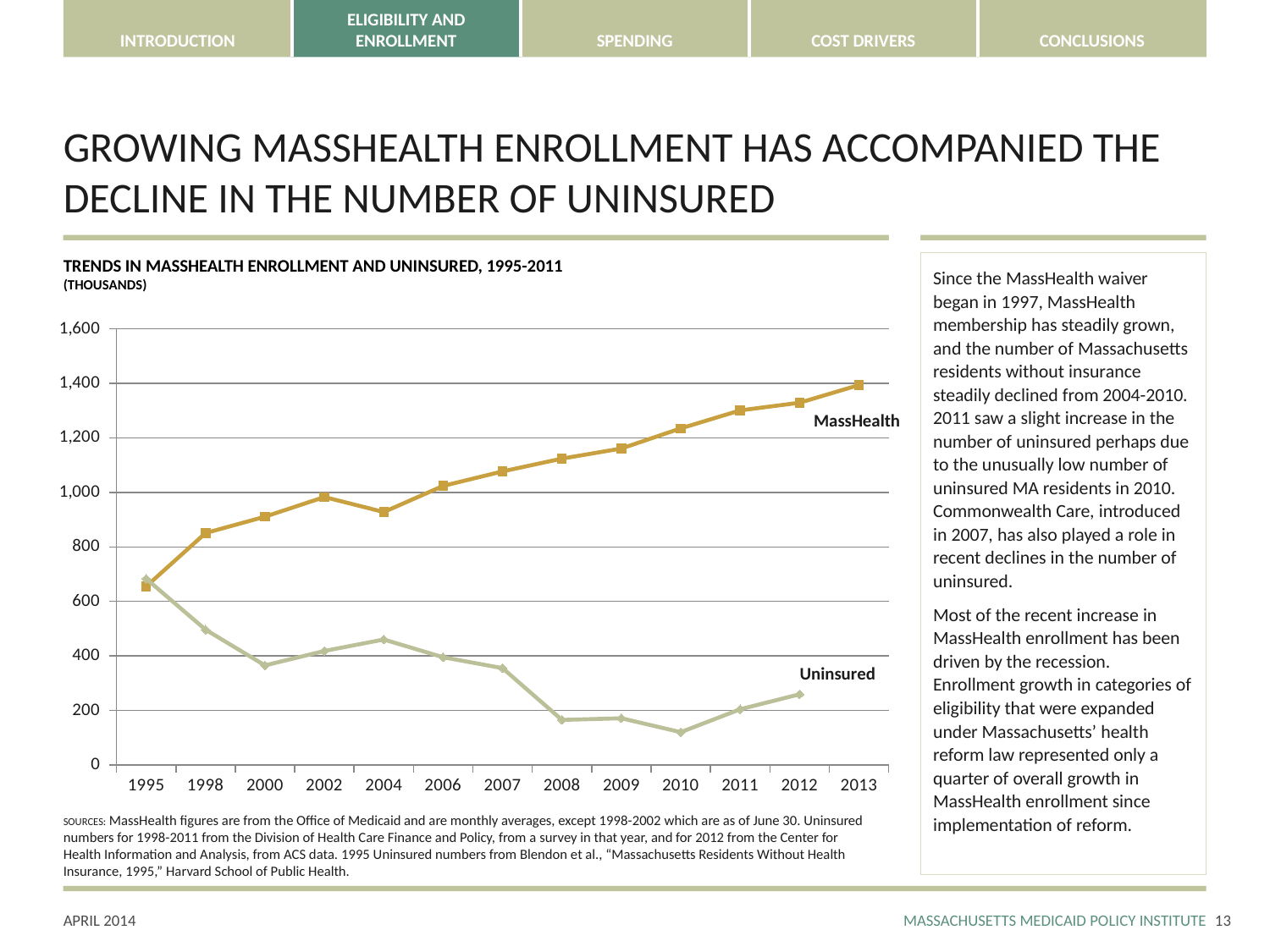
How many series are plotted in the chart? 2 In which year does the MassHealth series reach its highest value? 2013 Is the MassHealth value for 2004 greater or less than 1,000? less Which series has the larger value in 2012, MassHealth or Uninsured? MassHealth Is the Uninsured value for 2010 greater or less than 200? less In which year does the Uninsured series reach its lowest value? 2010 Is the Uninsured value for 2000 greater or less than 400? less How many years are labeled on the x axis of the chart? 13 What kind of chart is shown on the slide? line chart In which year is the Uninsured series at its highest value? 1995 Does the MassHealth series generally rise or fall from 1995 to 2013? rise